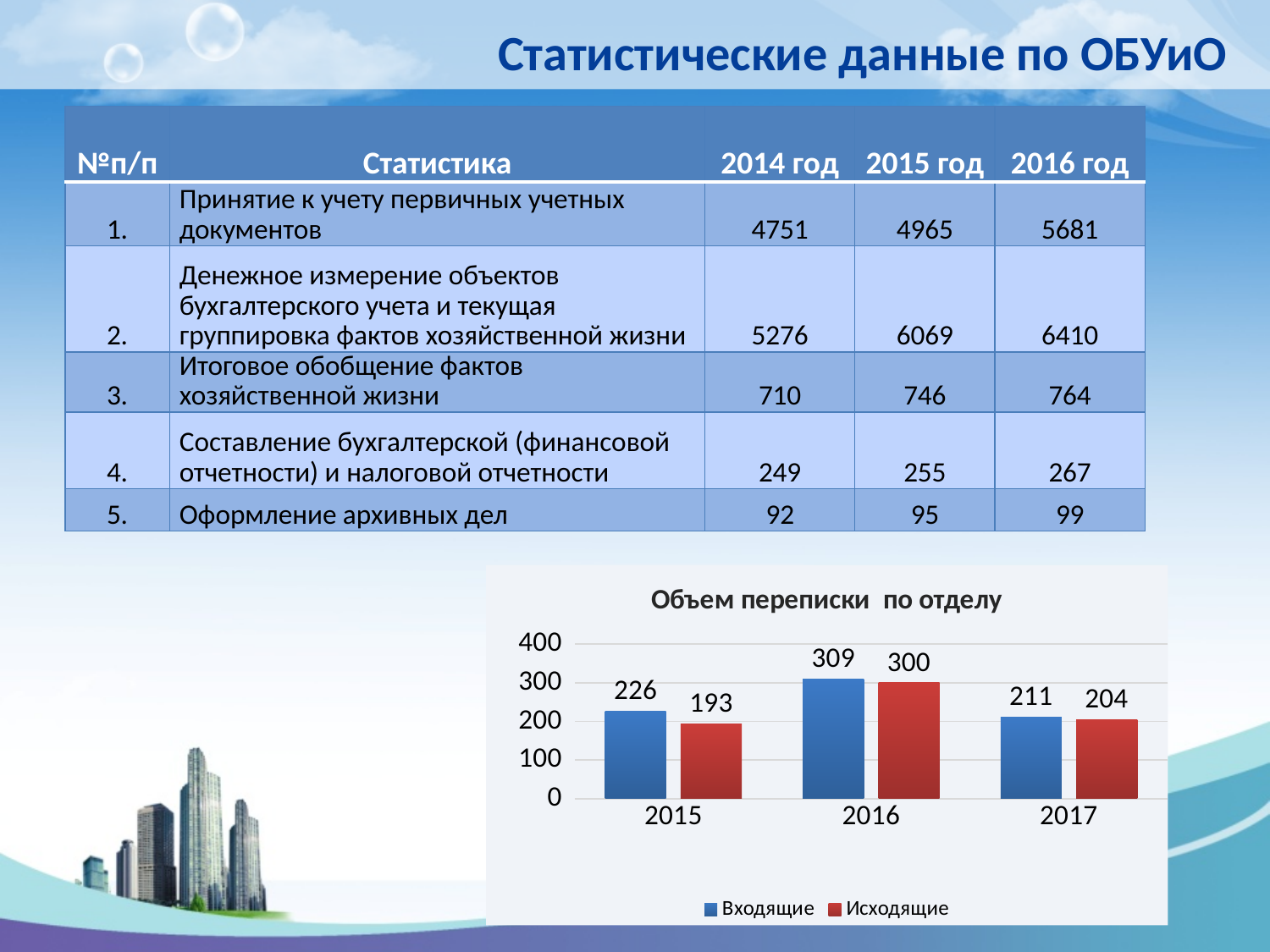
What is the difference between Входящие and Исходящие in 2015 on the chart? 33 How many years are shown on the x axis of the chart? 3 In which year is the Входящие value highest on the chart? 2016 In which year is the Исходящие value lowest on the chart? 2015 What is the title of the chart on the slide? Объем переписки по отделу What is the difference between the Входящие values for 2016 and 2017 on the chart? 98 What is the value for Исходящие in 2015 on the chart? 193 How many series does the chart legend list? 2 Is the value for Исходящие in 2016 greater or less than 200? greater What is the value for Исходящие in 2017 on the chart? 204 What is the value for Входящие in 2016 on the chart? 309 Which is larger on the chart: Входящие in 2015 or Исходящие in 2017? Входящие in 2015